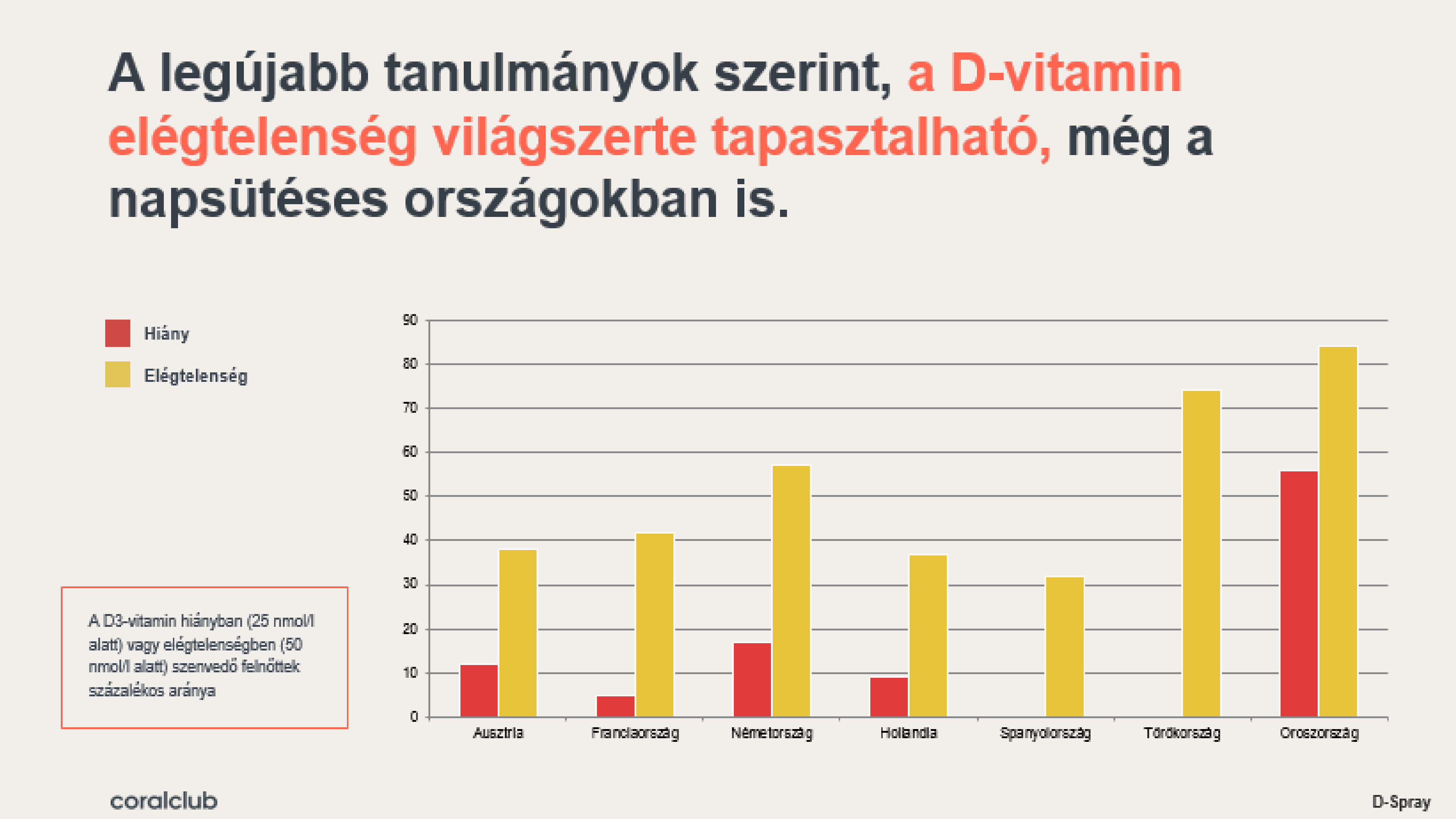
Is the Hiány value for Oroszország greater or less than 50? greater Is the Hiány value for Németország greater or less than 20? less How many series does the chart's legend list? 2 Which is larger, the Elégtelenség value for Németország or for Franciaország? Németország Which country has the lowest Elégtelenség value? Spanyolország Is the Elégtelenség value for Oroszország greater or less than 80? greater Which country has the highest Hiány value? Oroszország Which country has the highest Elégtelenség value? Oroszország How many countries are shown on the x axis of the chart? 7 What kind of chart is shown on the slide? bar chart Which colour represents the Hiány series in the chart? red